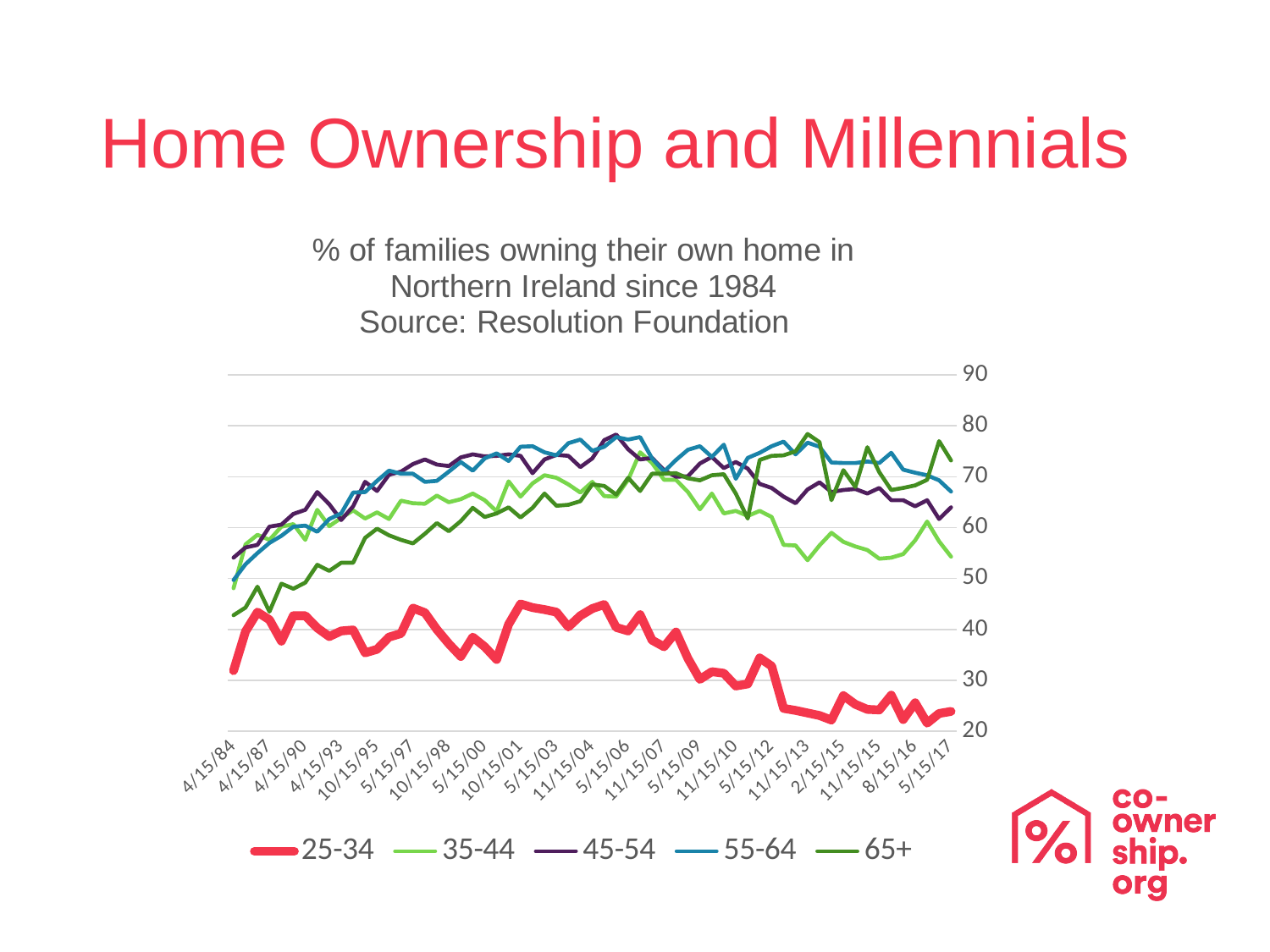
Is the value for the 45-54 group at 5/15/17 greater or less than 70? less Is the value for the 25-34 group at 5/15/17 greater or less than 30? less Which age group is plotted with the thick red line? 25-34 At 5/15/17, which is larger: the value for 25-34 or the value for 35-44? 35-44 What is the source of the data cited in the chart title? Resolution Foundation Does the home ownership rate for the 65+ group rise or fall between 4/15/84 and 11/15/13? rise What kind of chart is shown on the slide? line chart Which age group has the lowest home ownership rate across the whole period shown? 25-34 Is the value for the 35-44 group at 5/15/17 greater or less than 50? greater How many series does the legend list? 5 Does the home ownership rate for the 25-34 group rise or fall between 5/15/06 and 5/15/17? fall